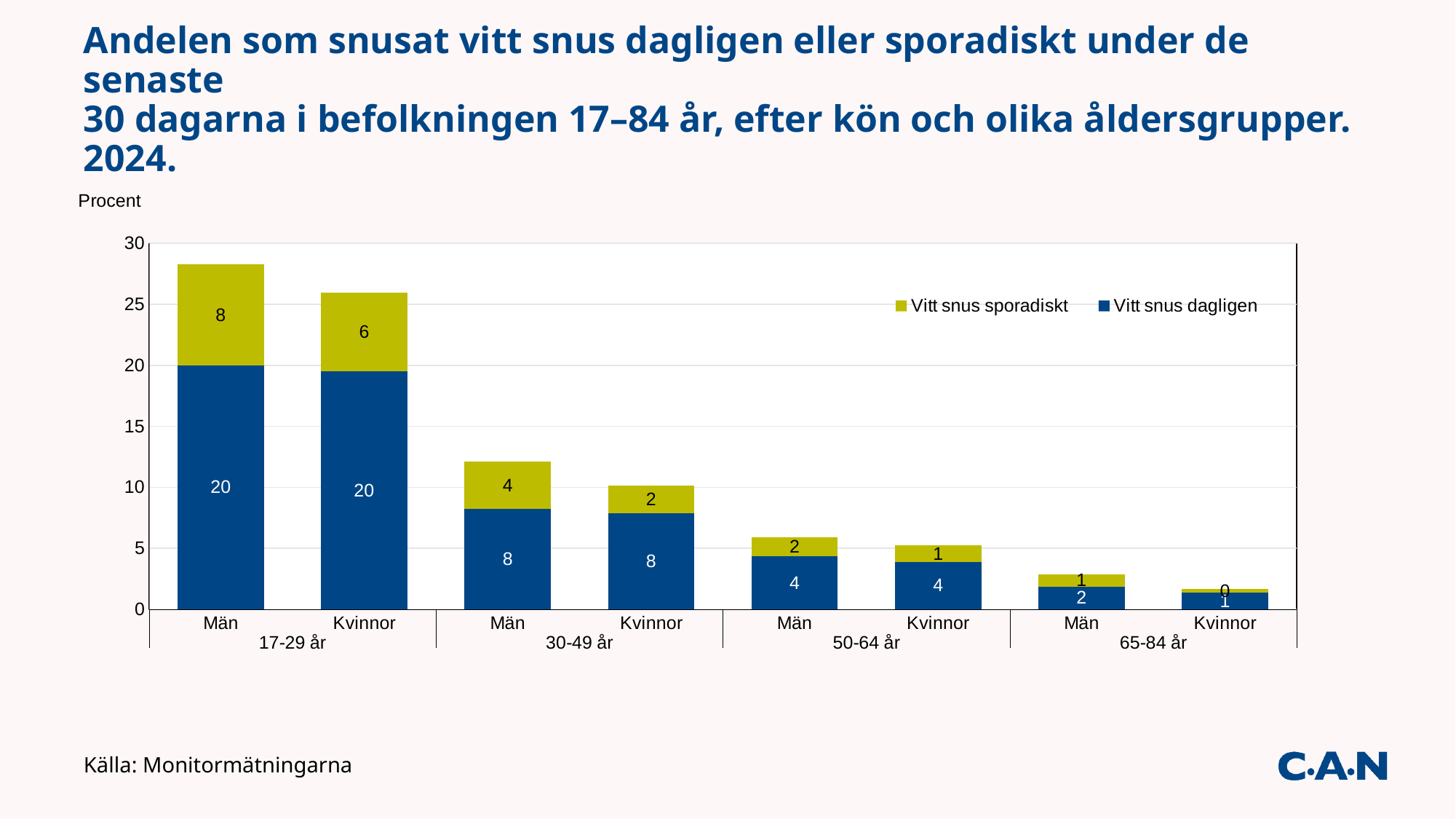
Which bar has the lowest total? Kvinnor, 65-84 år What is the value of Vitt snus sporadiskt for Kvinnor aged 65-84 år? 0 Which bar has the highest total? Män, 17-29 år What kind of chart is shown on the slide? Stacked bar chart Is the total for Män aged 30-49 år greater or less than 10? greater What is the value of Vitt snus sporadiskt for Män aged 30-49 år? 4 What is the value of Vitt snus dagligen for Män aged 17-29 år? 20 What is the value of Vitt snus dagligen for Kvinnor aged 50-64 år? 4 What is the value of Vitt snus sporadiskt for Kvinnor aged 17-29 år? 6 How many bars are plotted in the chart? 8 What is the difference between the Vitt snus sporadiskt values for Män and Kvinnor aged 17-29 år? 2 How many series does the legend list? 2